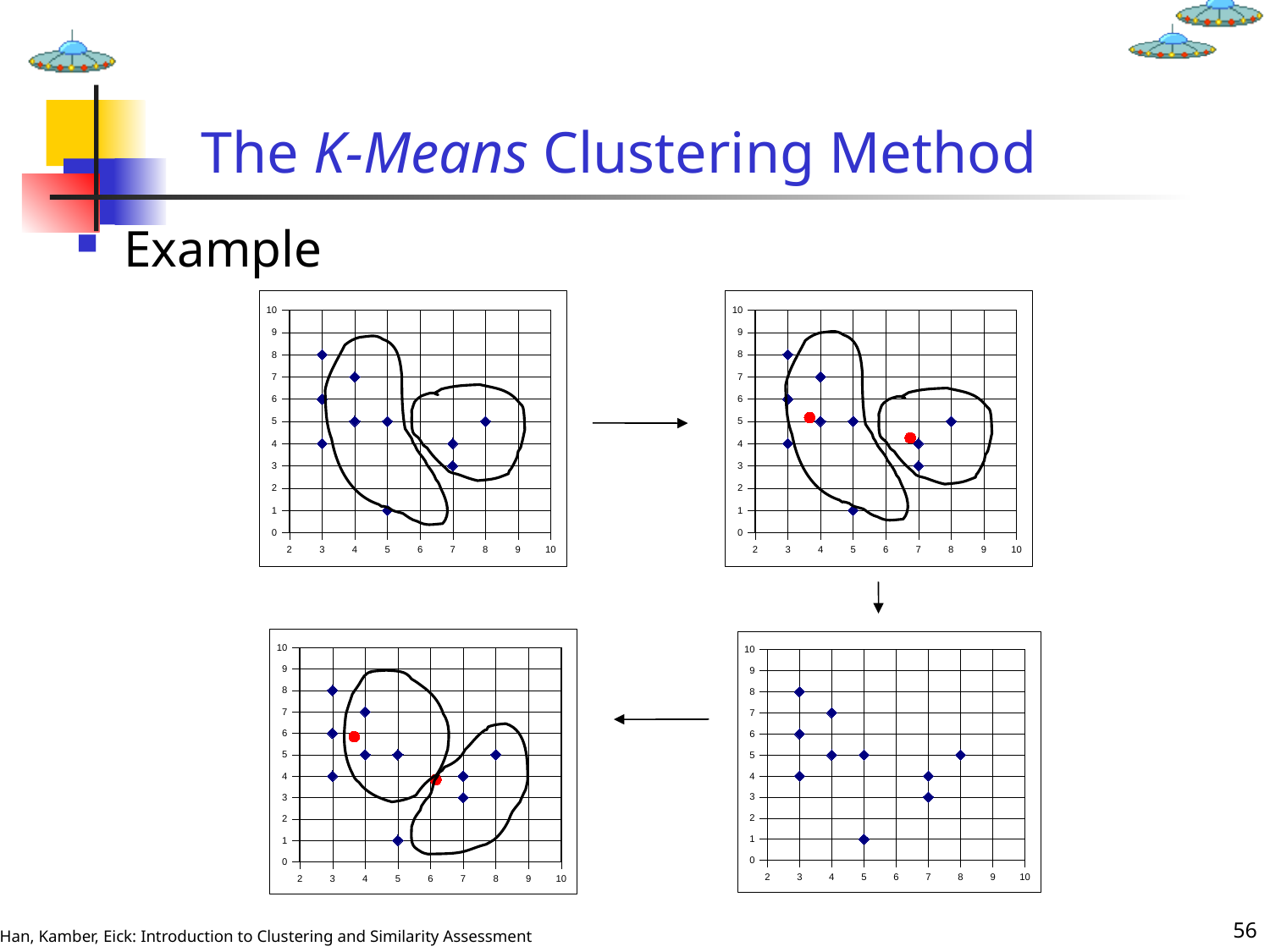
How many blue data points are plotted in the bottom-right chart? 10 In the bottom-right chart, what is the highest y value among the plotted points? 8 What is the maximum value shown on the y axis of the top-left chart? 10 In the bottom-right chart, which is higher on the y axis: the point at x = 8 or the lowest point at x = 5? the point at x = 8 In the bottom-right chart, what is the lowest y value among the plotted points? 1 In the bottom-right chart, what is the difference between the highest y value and the lowest y value of the plotted points? 7 In the bottom-right chart, what is the y value of the point at x = 8? 5 In the bottom-right chart, how many points are plotted at x = 3? 3 In the top-right chart, how many red dots are shown? 2 What kind of chart is the bottom-right chart on the slide? scatter plot How many charts are shown on the slide? 4 In the bottom-right chart, is the y value of the point at x = 8 greater or less than 4? greater